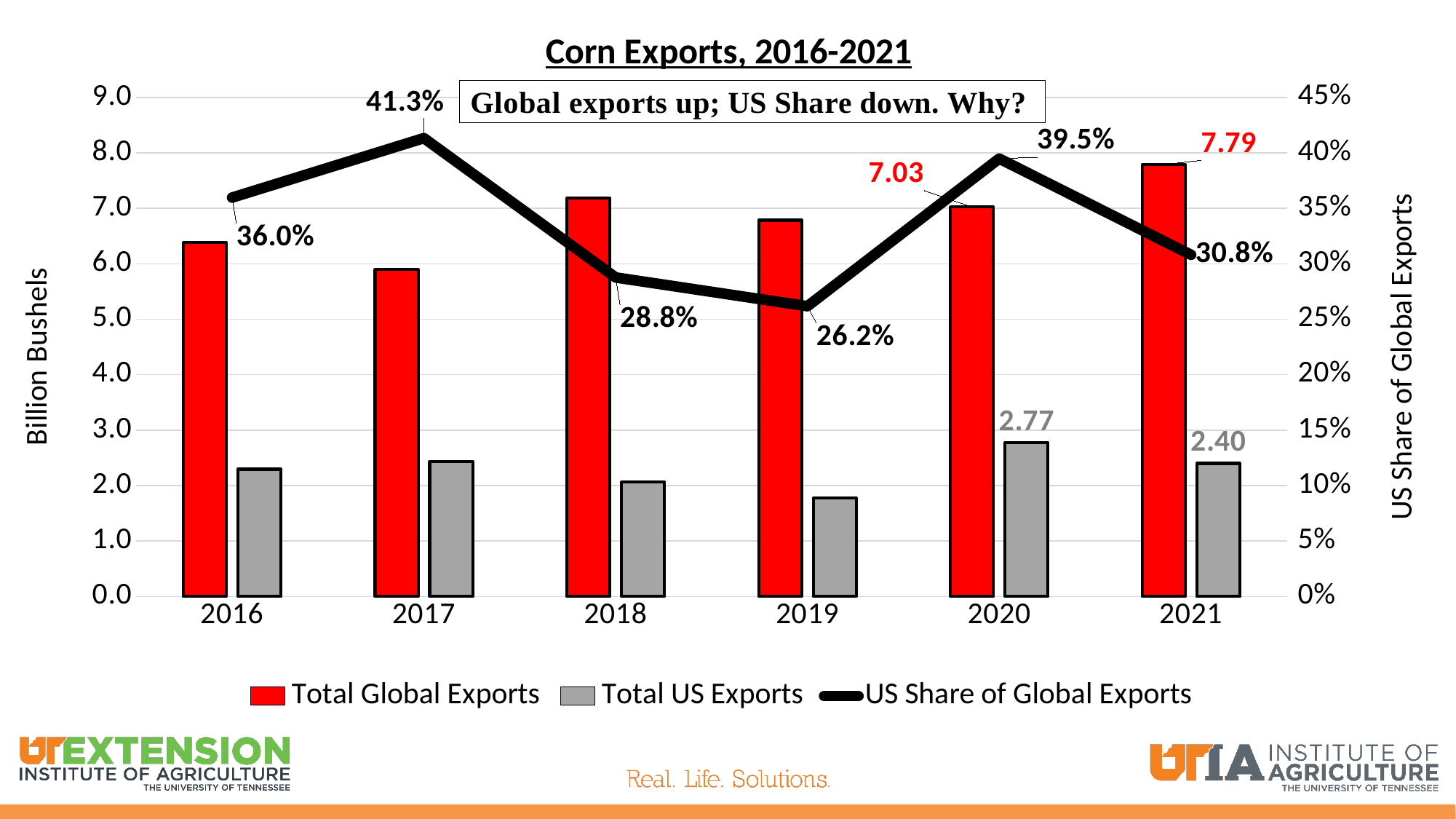
What was the US Share of Global Exports in 2017? 41.3% How many years are shown on the x axis? 6 In which year was the US Share of Global Exports highest? 2017 How many series does the legend list? 3 By how much did Total Global Exports increase from 2020 to 2021? 0.76 What kind of chart is this? Bar chart with a line What was the value of Total US Exports in 2020? 2.77 In which year was the US Share of Global Exports lowest? 2019 What was the value of Total Global Exports in 2021? 7.79 What is the title of the chart? Corn Exports, 2016-2021 What is the difference between the US Share of Global Exports in 2017 and in 2019? 15.1% Is the value of Total Global Exports in 2016 greater or less than 6.0? greater